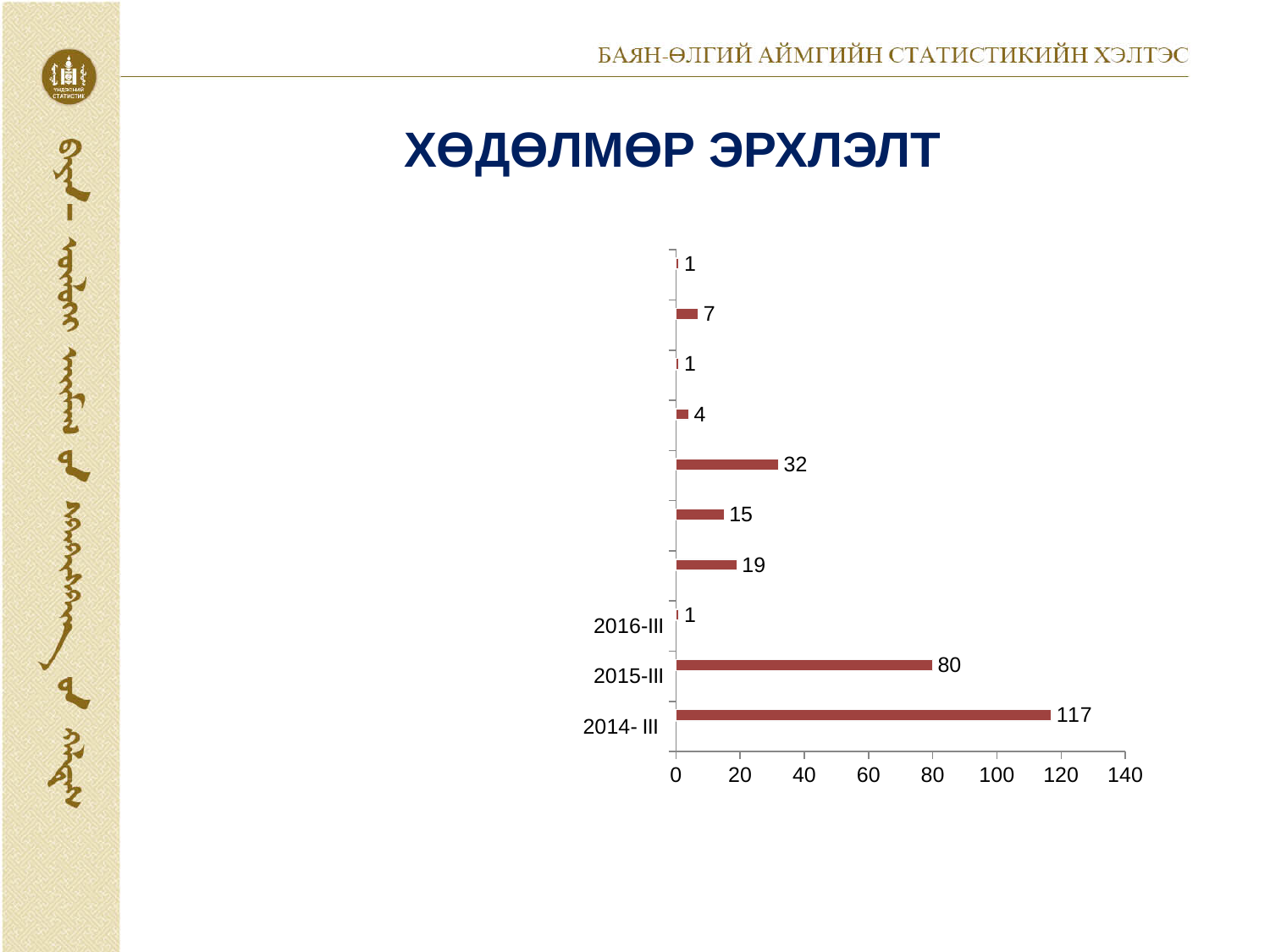
Which is larger, the value for 2015-III or the value for 2016-III? 2015-III Which of the labeled categories has the highest value? 2014- III What kind of chart is shown on the slide? bar chart What is the value for 2016-III? 1 How many bars are plotted in the chart? 10 Which of the labeled categories has the lowest value? 2016-III What is the value for 2015-III? 80 What is the value for 2014- III? 117 What is the largest data label shown on the chart? 117 What is the difference between the values for 2014- III and 2015-III? 37 What is the title of the slide above the chart? ХӨДӨЛМӨР ЭРХЛЭЛТ Is the value for 2014- III greater or less than 100? greater